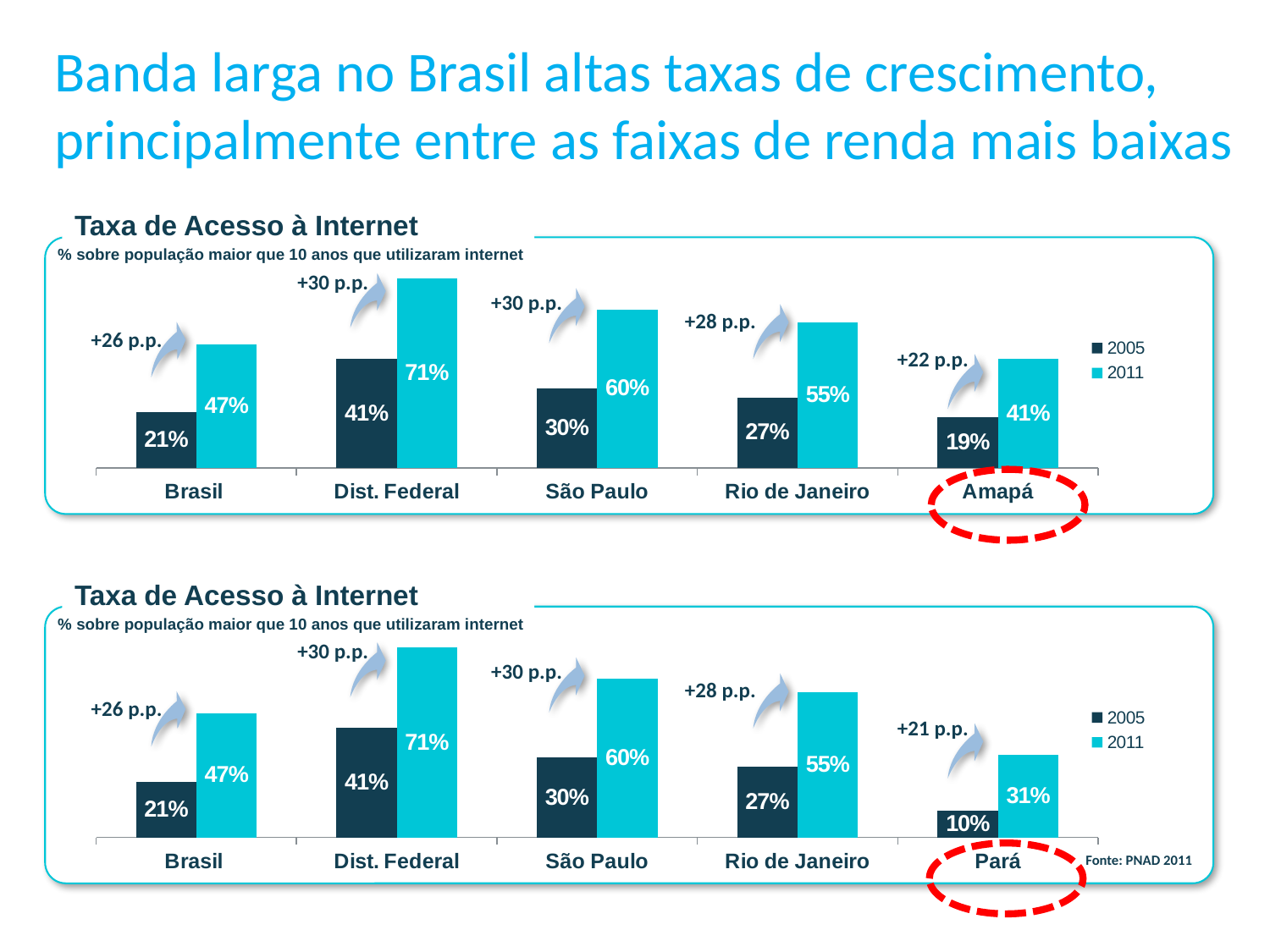
In the top chart (with Amapá), what was the 2011 value for Amapá? 41% How many categories are shown on the x axis of the bottom chart (with Pará)? 5 In the top chart (with Amapá), which category has the lowest 2005 value? Amapá What is the title of the top chart? Taxa de Acesso à Internet In the top chart (with Amapá), what was the 2005 value for Dist. Federal? 41% In the bottom chart (with Pará), what was the 2005 value for Pará? 10% In the bottom chart (with Pará), what is the difference between the 2011 and 2005 values for Pará? 21 percentage points In the top chart (with Amapá), which is larger: the 2011 value for São Paulo or the 2011 value for Rio de Janeiro? São Paulo What type of chart is the bottom chart (with Pará)? Bar chart In the bottom chart (with Pará), which category has the highest 2011 value? Dist. Federal How many series does the legend of the top chart (with Amapá) list? 2 In the top chart (with Amapá), what is the 2005 value for Rio de Janeiro? 27%